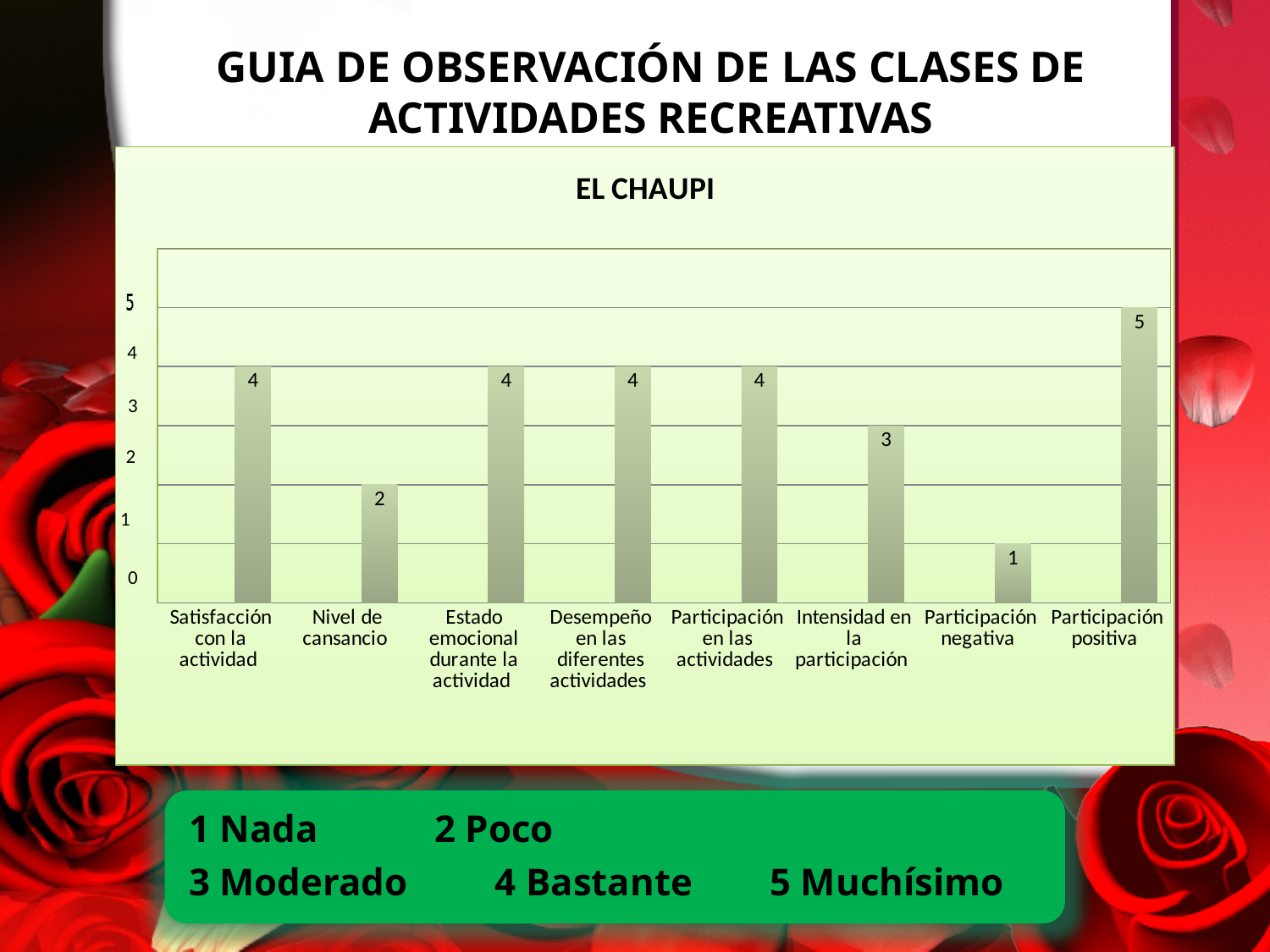
What is the value for Nivel de cansancio? 2 Which is larger, the value for Intensidad en la participación or the value for Nivel de cansancio? Intensidad en la participación What kind of chart is shown? Bar chart What is the value for Intensidad en la participación? 3 What is the title of the chart? EL CHAUPI Which category has the lowest value? Participación negativa Which category has the highest value? Participación positiva What is the difference between the values for Participación positiva and Participación negativa? 4 How many categories are shown on the x axis? 8 What is the difference between the values for Desempeño en las diferentes actividades and Nivel de cansancio? 2 What is the value for Satisfacción con la actividad? 4 What is the value for Participación negativa? 1